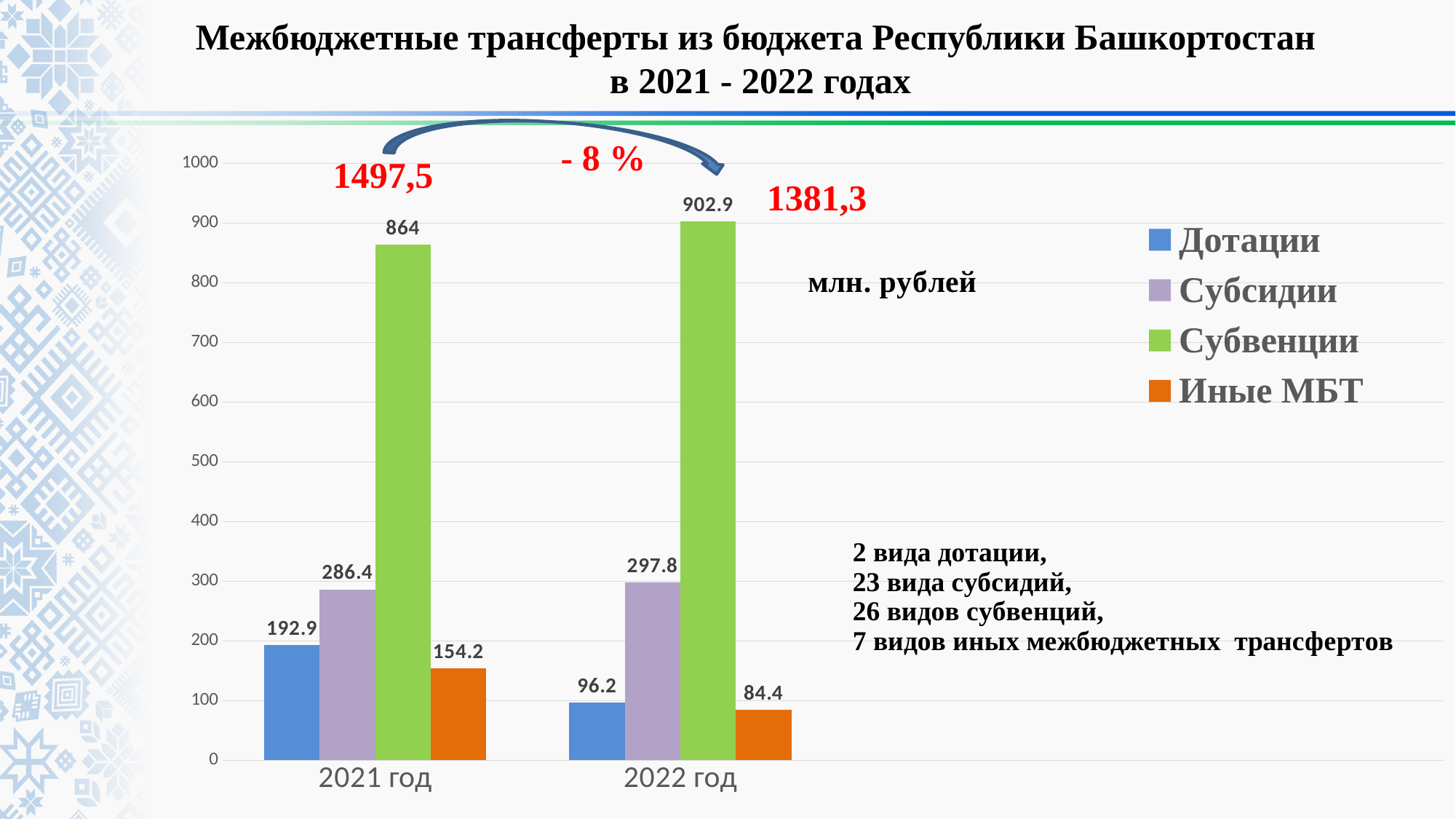
Which is larger: Дотации in 2021 год or Дотации in 2022 год? Дотации in 2021 год How many series does the legend list? 4 What is the value for Иные МБТ in 2021 год? 154.2 Which series has the highest value in 2022 год? Субвенции How many year categories are shown on the x axis? 2 What is the value for Дотации in 2022 год? 96.2 Is the value for Субвенции in 2022 год greater or less than 900? greater What is the value for Субвенции in 2021 год? 864 Which series has the lowest value in 2022 год? Иные МБТ What kind of chart is shown on the slide? Bar chart What colour represents Субвенции in the legend? Green What is the difference between the Субсидии values for 2022 год and 2021 год? 11.4